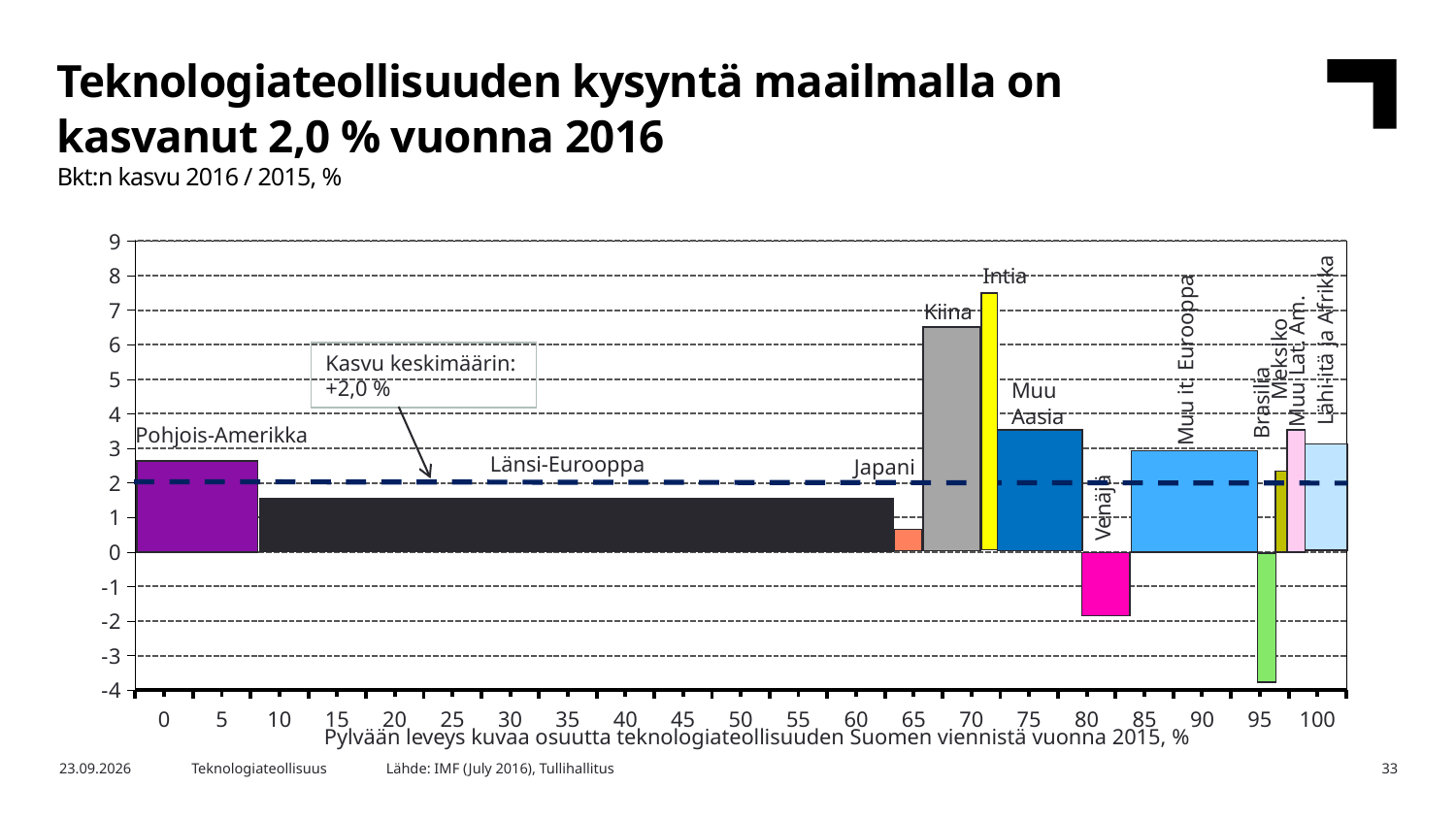
Which region has the highest GDP growth bar in the chart? Intia Is the value for Japani greater or less than 1? less Is the value for Pohjois-Amerikka greater or less than 2? greater Is the value for Venäjä greater or less than -1? less Which has the larger GDP growth, Pohjois-Amerikka or Länsi-Eurooppa? Pohjois-Amerikka What type of chart is shown on the slide? Bar chart Which region has the lowest GDP growth bar in the chart? Brasilia How many regions are shown as bars in the chart? 12 Which has the larger GDP growth, Kiina or Muu Aasia? Kiina What average growth value is shown by the dashed line annotation in the chart? +2,0 %